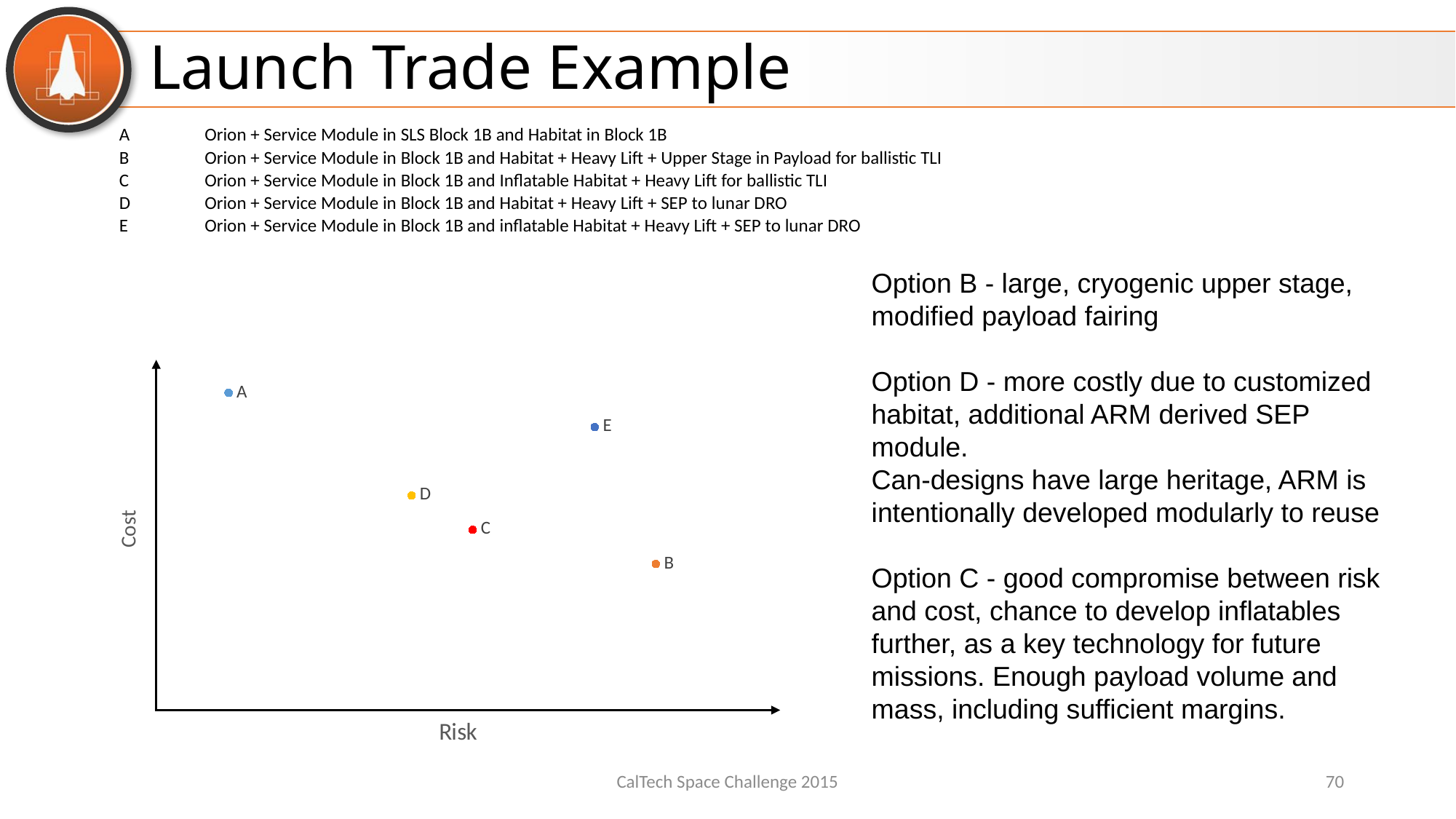
Which option has the higher cost, E or D? E Which option has the higher risk, D or C? C What is the label of the horizontal axis of the chart? Risk Which option has the highest risk on the chart? B What is the label of the vertical axis of the chart? Cost Which option has the higher cost, D or C? D Which option has the lowest cost on the chart? B Which option has the lowest risk on the chart? A How many points are plotted on the chart? 5 What kind of chart is shown on the slide? Scatter chart Which option has the highest cost on the chart? A